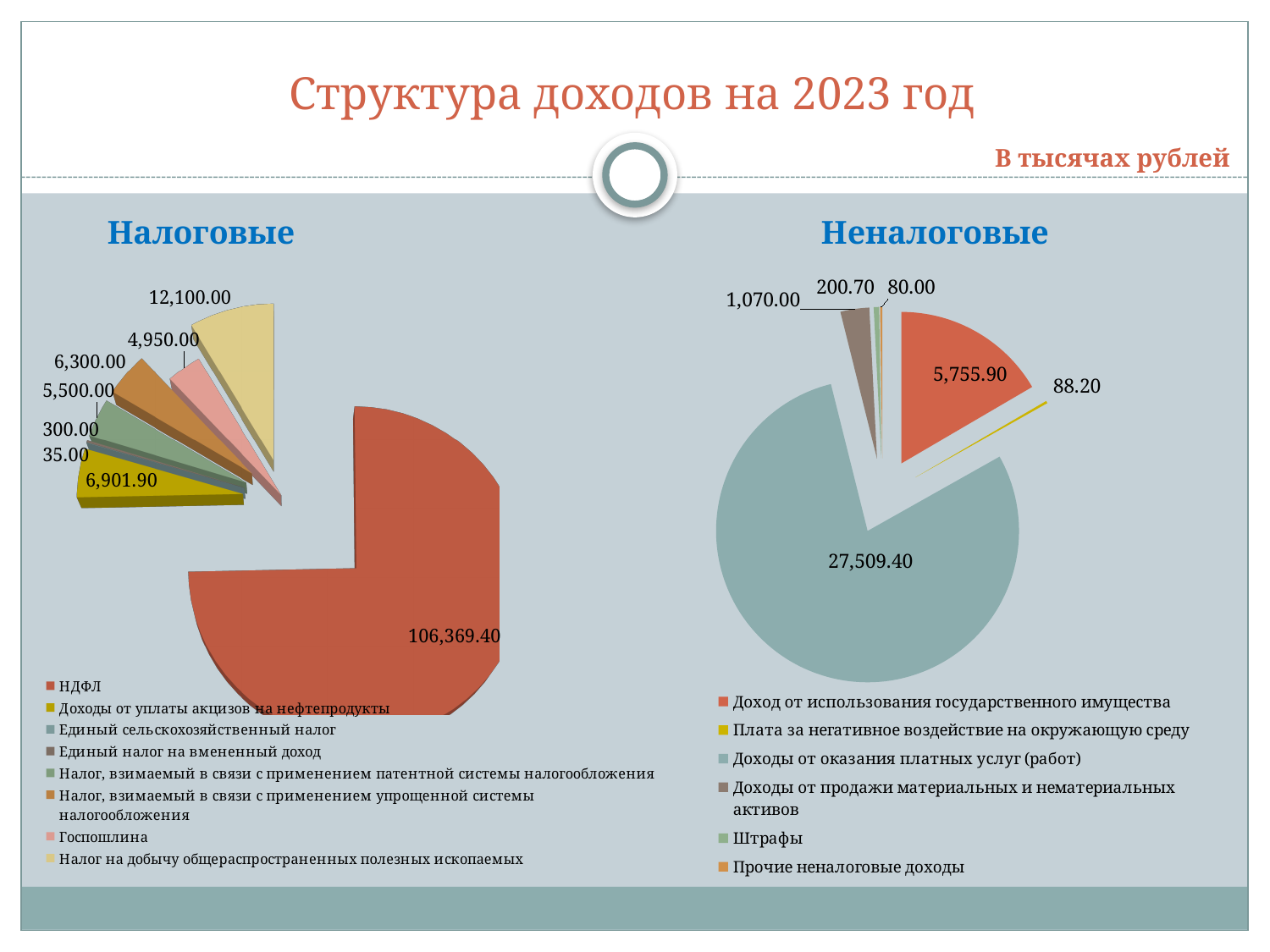
How many categories does the legend of the "Налоговые" chart list? 8 In the "Налоговые" chart, what is the value for Налог на добычу общераспространенных полезных ископаемых? 12,100.00 In the "Неналоговые" chart, what is the value for Штрафы? 200.70 In what units are the values on the slide expressed? В тысячах рублей In the "Налоговые" chart, which is larger: Доходы от уплаты акцизов на нефтепродукты or Налог, взимаемый в связи с применением упрощенной системы налогообложения? Доходы от уплаты акцизов на нефтепродукты In the "Налоговые" chart, which category has the largest slice? НДФЛ In the "Неналоговые" chart, what is the difference between Доход от использования государственного имущества and Доходы от продажи материальных и нематериальных активов? 4,685.90 In the "Налоговые" chart, what is the difference between Налог на добычу общераспространенных полезных ископаемых and Госпошлина? 7,150.00 In the "Неналоговые" chart, what is the value for Доходы от оказания платных услуг (работ)? 27,509.40 In the "Налоговые" chart, what is the value for НДФЛ? 106,369.40 In the "Неналоговые" chart, which category has the smallest value? Прочие неналоговые доходы What kind of chart is used for the "Налоговые" chart on the left? Pie chart